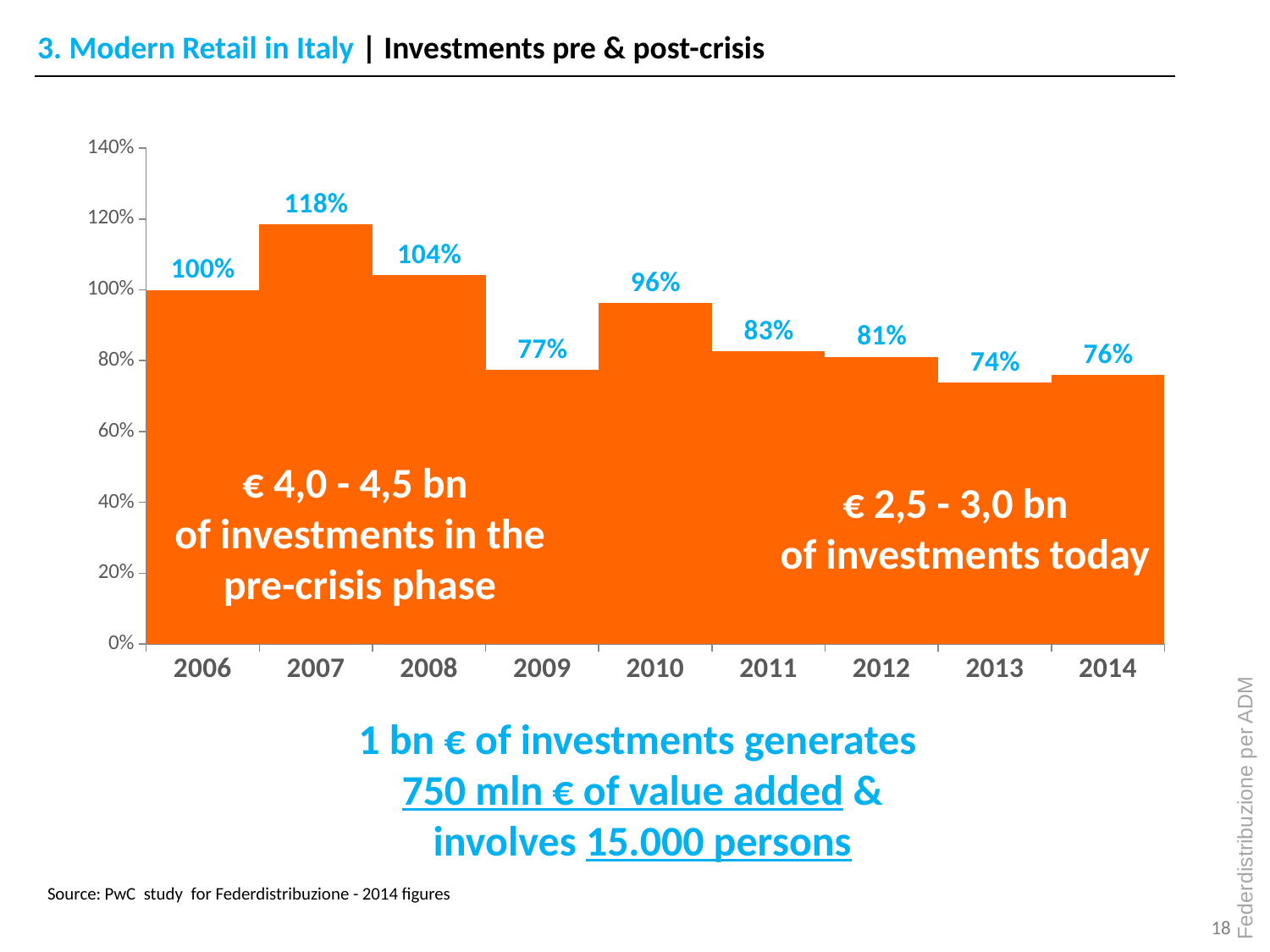
What is the difference between the values for 2006 and 2009? 23% Is the value for 2008 greater or less than 100%? greater What is the value for 2007? 118% What is the value for 2009? 77% Which year has the lowest value? 2013 Do the values generally rise or fall from 2007 to 2013? fall Which is larger, the value for 2010 or the value for 2011? 2010 How many years are shown on the x axis? 9 What is the value for 2014? 76% Which year has the highest value? 2007 What kind of chart is this? bar chart What is the difference between the values for 2007 and 2013? 44%